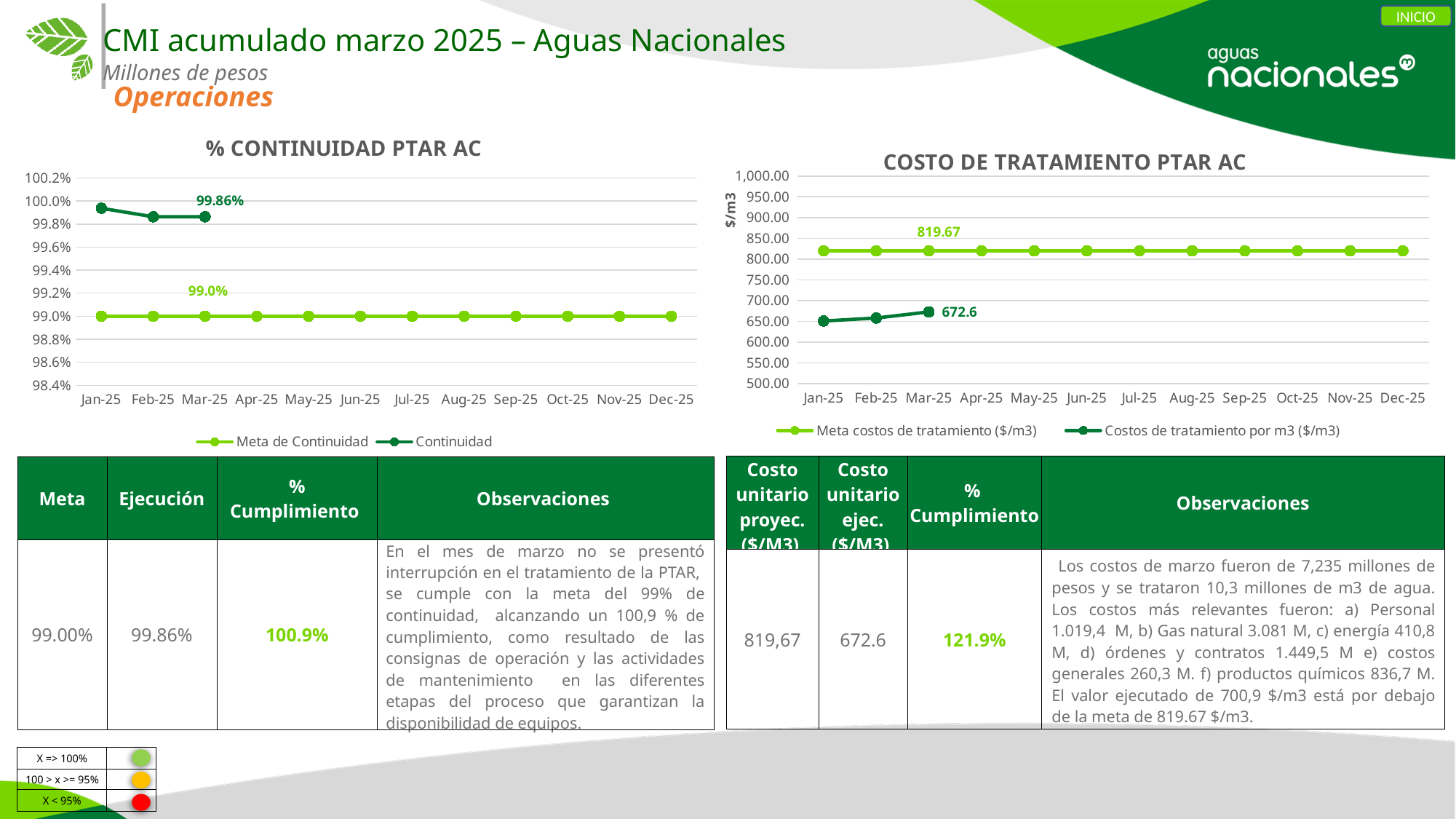
In the "COSTO DE TRATAMIENTO PTAR AC" chart, is the Costos de tratamiento por m3 value for Jan-25 greater or less than 700.00? less How many series does the legend of the "% CONTINUIDAD PTAR AC" chart list? 2 In the "% CONTINUIDAD PTAR AC" chart, what is the Continuidad value labeled for Mar-25? 99.86% In the "% CONTINUIDAD PTAR AC" chart, what value is labeled for the Meta de Continuidad series? 99.0% In the "COSTO DE TRATAMIENTO PTAR AC" chart, what value is labeled for the Meta costos de tratamiento series? 819.67 How many months are shown on the x axis of the "% CONTINUIDAD PTAR AC" chart? 12 In the "COSTO DE TRATAMIENTO PTAR AC" chart, what is the labeled value of Costos de tratamiento por m3 at Mar-25? 672.6 In the "% CONTINUIDAD PTAR AC" chart, is the Continuidad value for Jan-25 greater or less than 99.8%? greater In the "COSTO DE TRATAMIENTO PTAR AC" chart, what is the difference between the Meta costos de tratamiento (819.67) and the Mar-25 Costos de tratamiento por m3 (672.6)? 147.07 In the "% CONTINUIDAD PTAR AC" chart, which is higher at Mar-25: Continuidad or Meta de Continuidad? Continuidad In the "COSTO DE TRATAMIENTO PTAR AC" chart, does the Costos de tratamiento por m3 series rise or fall from Jan-25 to Mar-25? rise What type of chart is the "% CONTINUIDAD PTAR AC" chart? line chart